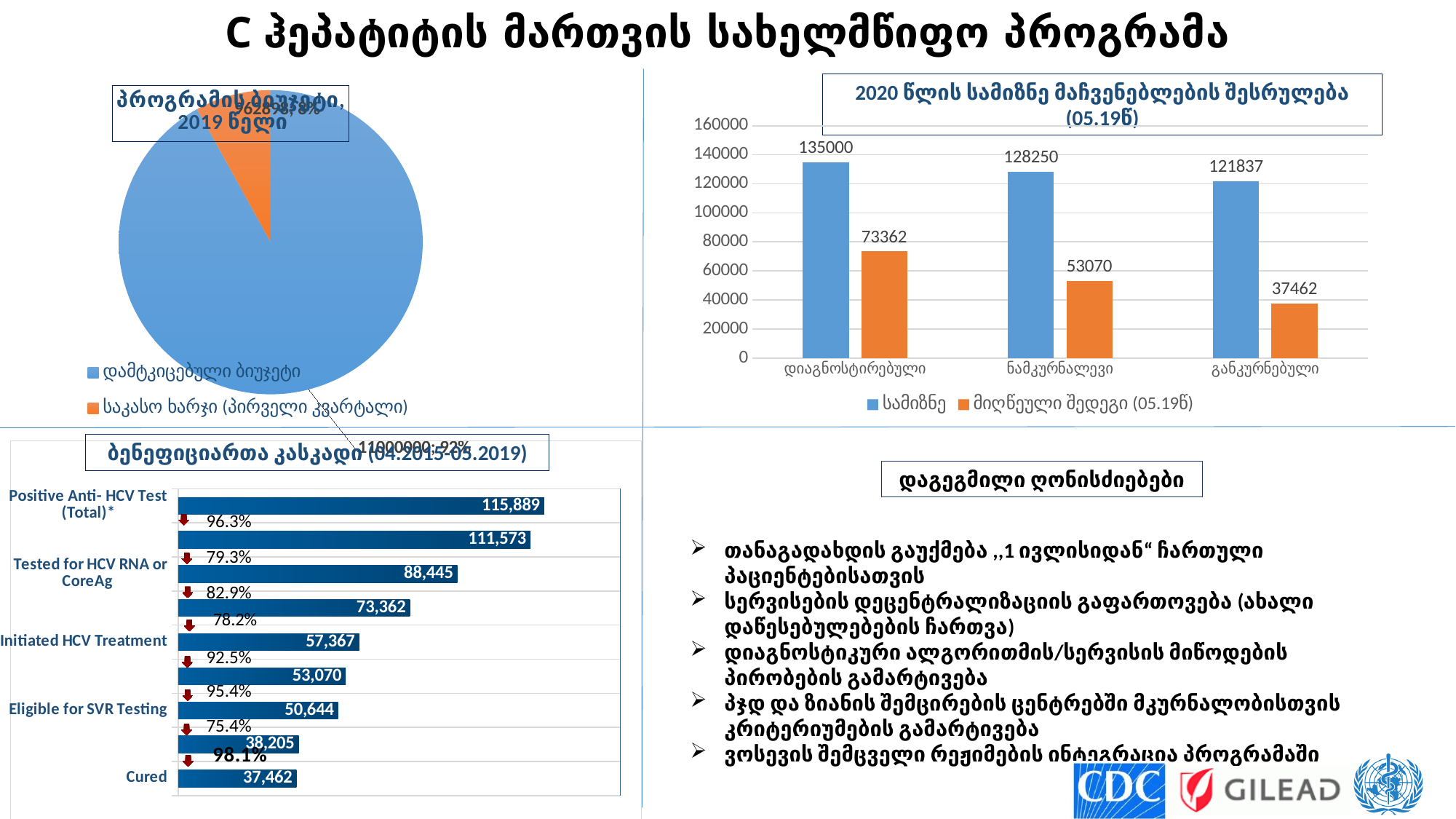
In the top-right chart '2020 წლის სამიზნე მაჩვენებლების შესრულება', what is the difference between the სამიზნე and მიღწეული შედეგი values for ნამკურნალევი? 75180 In the bottom-left chart 'ბენეფიციართა კასკადი (04.2015-05.2019)', what kind of chart is it? bar chart In the top-right chart '2020 წლის სამიზნე მაჩვენებლების შესრულება', what is the სამიზნე value for დიაგნოსტირებული? 135000 In the top-right chart '2020 წლის სამიზნე მაჩვენებლების შესრულება', what is the მიღწეული შედეგი value for განკურნებული? 37462 In the top-left pie chart 'პროგრამის ბიუჯეტი, 2019 წელი', which legend entry is shown in orange? საკასო ხარჯი (პირველი კვარტალი) In the top-right chart '2020 წლის სამიზნე მაჩვენებლების შესრულება', do the სამიზნე values rise or fall from left to right across the categories? fall In the top-right chart '2020 წლის სამიზნე მაჩვენებლების შესრულება', how many categories are shown on the x axis? 3 In the bottom-left chart 'ბენეფიციართა კასკადი (04.2015-05.2019)', what is the value for Cured? 37,462 In the bottom-left chart 'ბენეფიციართა კასკადი (04.2015-05.2019)', what is the value of the top bar, Positive Anti-HCV Test (Total)*? 115,889 In the top-right chart '2020 წლის სამიზნე მაჩვენებლების შესრულება', which category has the lowest მიღწეული შედეგი value? განკურნებული In the top-right chart '2020 წლის სამიზნე მაჩვენებლების შესრულება', how many series does the legend list? 2 What kind of chart is the top-left chart 'პროგრამის ბიუჯეტი, 2019 წელი'? pie chart